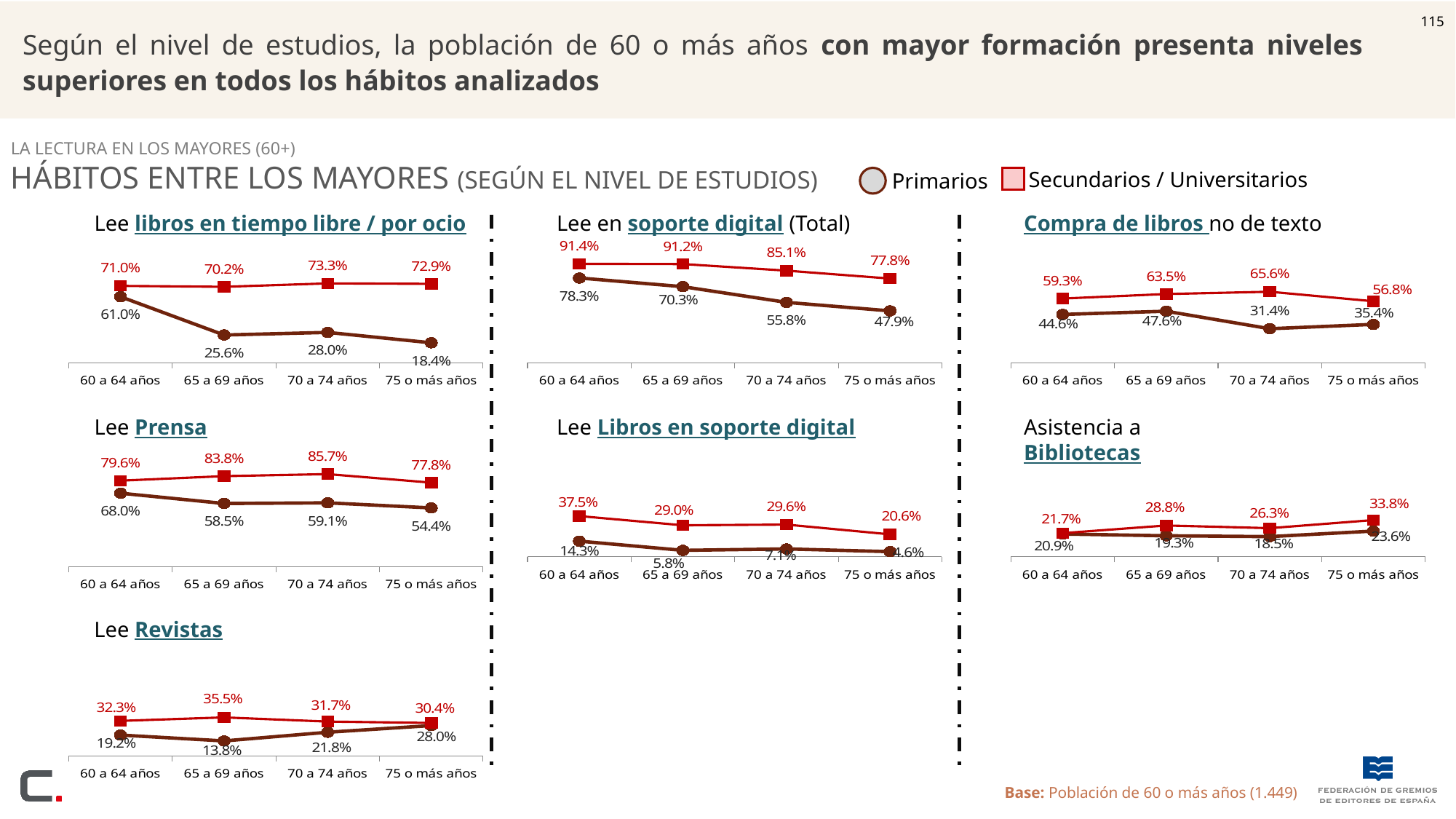
In the 'Lee Prensa' chart, which age group has the highest value for Secundarios / Universitarios? 70 a 74 años In the 'Asistencia a Bibliotecas' chart, what is the value for Secundarios / Universitarios in the 75 o más años group? 33.8% Which series is shown with red square markers in the legend? Secundarios / Universitarios How many age groups are shown on the x axis of the 'Asistencia a Bibliotecas' chart? 4 In the 'Compra de libros no de texto' chart, what is the difference between Secundarios / Universitarios and Primarios in the 70 a 74 años group? 34.2 percentage points In the 'Lee libros en tiempo libre / por ocio' chart, what is the value for Primarios in the 75 o más años group? 18.4% In the 'Lee en soporte digital (Total)' chart, do the Primarios values rise or fall from 60 a 64 años to 75 o más años? Fall How many series does the legend list for the charts on this slide? 2 In the 'Lee Revistas' chart, which is larger for Primarios: the value for 60 a 64 años or the value for 75 o más años? 75 o más años In the 'Lee Libros en soporte digital' chart, which age group has the lowest value for Primarios? 75 o más años In the 'Lee en soporte digital (Total)' chart, what is the value for Secundarios / Universitarios in the 60 a 64 años group? 91.4% What kind of chart is used for 'Lee Prensa'? Line chart